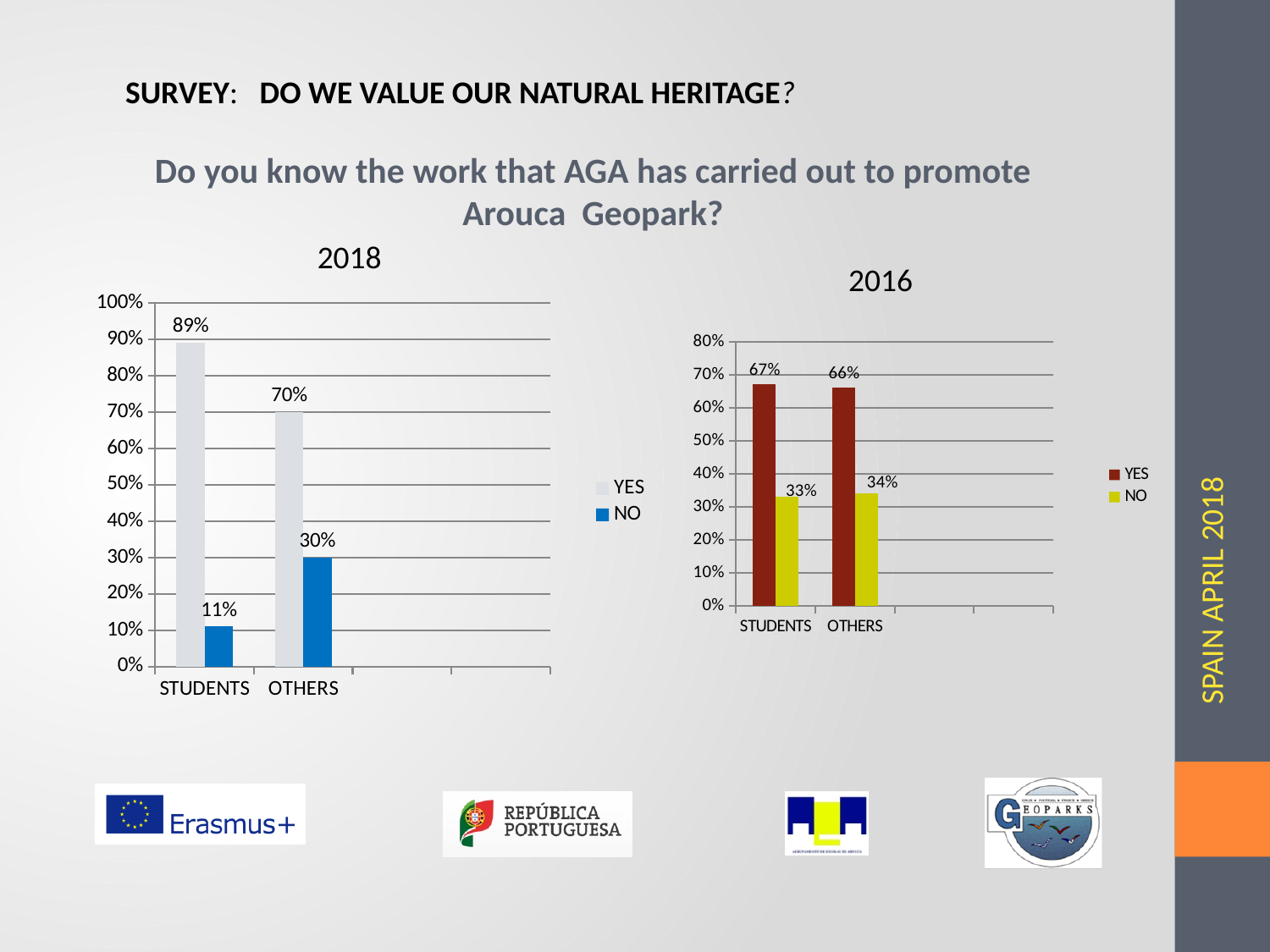
In the 2018 chart, what is the YES value for STUDENTS? 89% In the 2016 chart, is the YES value for STUDENTS greater or less than 60%? greater In the 2018 chart, what is the difference between the YES values for STUDENTS and OTHERS? 19% In the 2018 chart, which category has the lowest NO value? STUDENTS What kind of chart is the 2018 chart? bar chart In the 2018 chart, what is the NO value for OTHERS? 30% In the 2016 chart, what is the NO value for STUDENTS? 33% How many series does the legend of the 2016 chart list? 2 In the 2018 chart, which colour represents the NO series? blue In the 2018 chart, is the NO value for OTHERS larger or smaller than the NO value for STUDENTS? larger In the 2016 chart, what is the difference between the YES and NO values for STUDENTS? 34% In the 2016 chart, what is the YES value for OTHERS? 66%